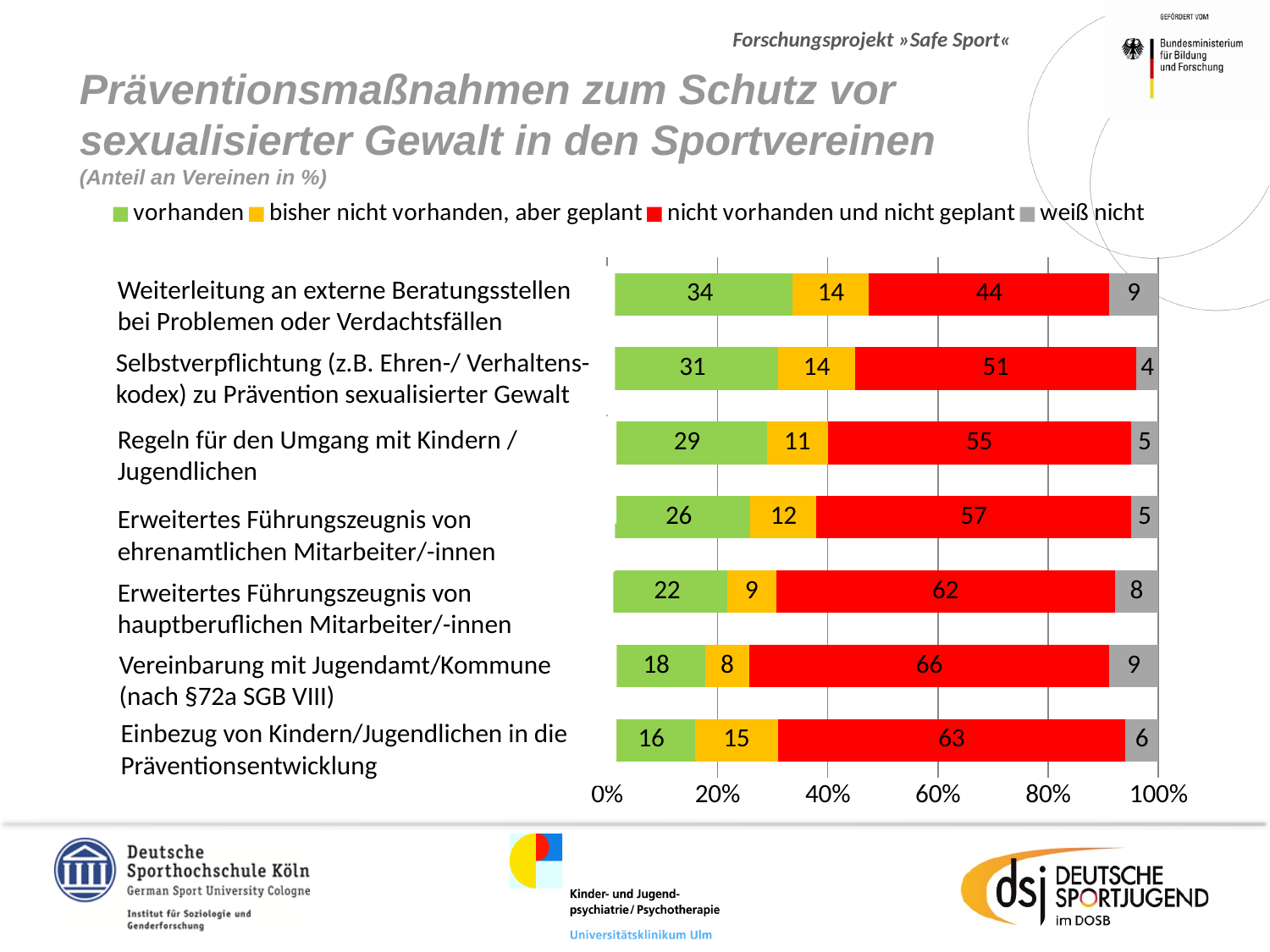
What is the value for "bisher nicht vorhanden, aber geplant" for "Einbezug von Kindern/Jugendlichen in die Präventionsentwicklung"? 15 Which category has the highest value for "vorhanden"? Weiterleitung an externe Beratungsstellen bei Problemen oder Verdachtsfällen What is the value for "vorhanden" for "Weiterleitung an externe Beratungsstellen bei Problemen oder Verdachtsfällen"? 34 Which category has the lowest value for "vorhanden"? Einbezug von Kindern/Jugendlichen in die Präventionsentwicklung How many series does the legend list? 4 What is the difference between the "nicht vorhanden und nicht geplant" values for "Regeln für den Umgang mit Kindern / Jugendlichen" and "Selbstverpflichtung (z.B. Ehren-/ Verhaltenskodex) zu Prävention sexualisierter Gewalt"? 4 What is the total of the stacked bar for "Regeln für den Umgang mit Kindern / Jugendlichen"? 100 How many categories (prevention measures) are shown in the chart? 7 What is the value for "nicht vorhanden und nicht geplant" for "Vereinbarung mit Jugendamt/Kommune (nach §72a SGB VIII)"? 66 What kind of chart is shown on the slide? Stacked bar chart Which is larger: the "vorhanden" value for "Erweitertes Führungszeugnis von ehrenamtlichen Mitarbeiter/-innen" or for "Erweitertes Führungszeugnis von hauptberuflichen Mitarbeiter/-innen"? Erweitertes Führungszeugnis von ehrenamtlichen Mitarbeiter/-innen Which colour represents "nicht vorhanden und nicht geplant" in the chart? Red